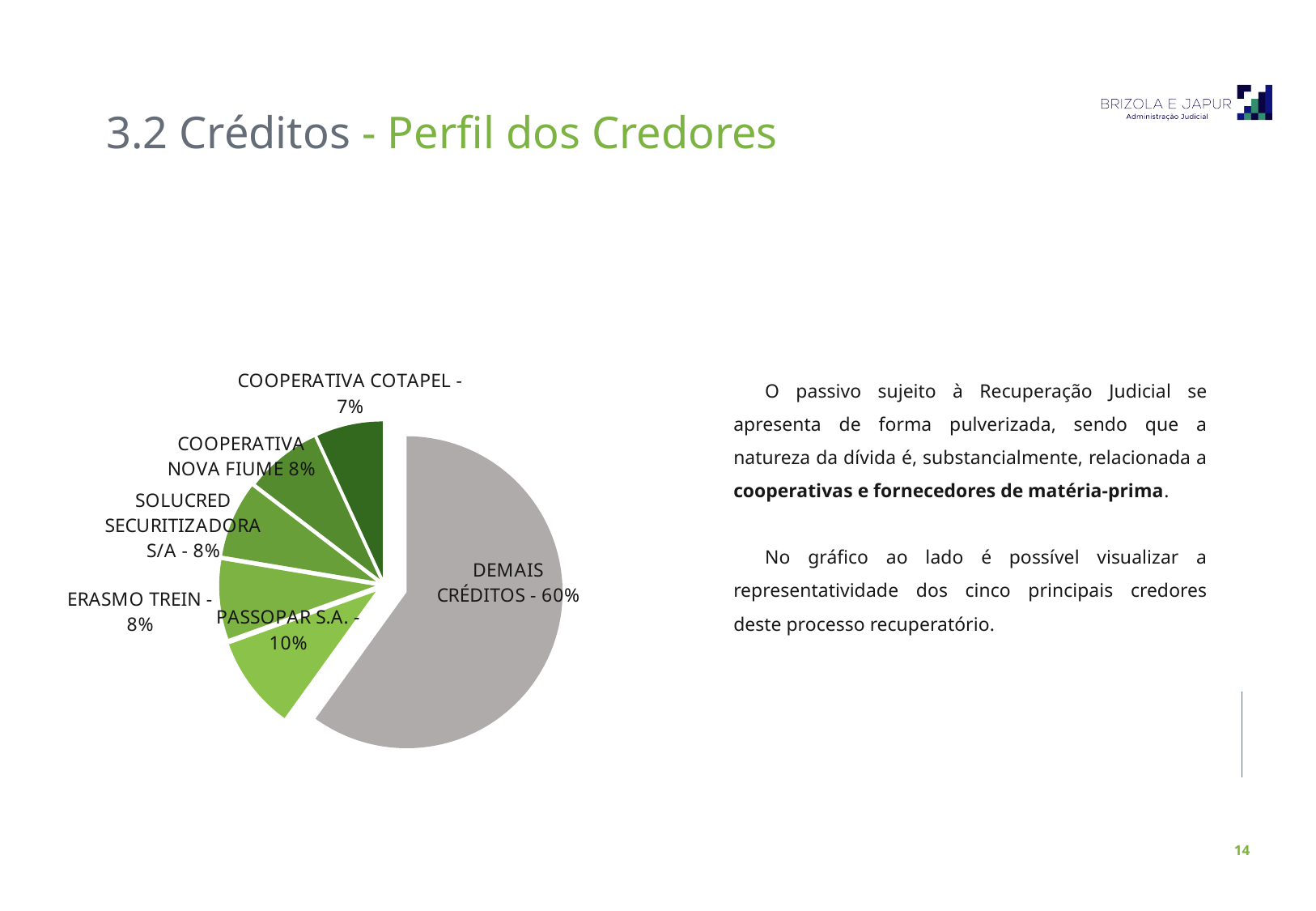
What is the difference between the share of DEMAIS CRÉDITOS and the share of PASSOPAR S.A.? 50% Which slice of the pie chart is the largest? DEMAIS CRÉDITOS What colour is the DEMAIS CRÉDITOS slice? Grey What share of the pie does DEMAIS CRÉDITOS represent? 60% What is the combined share of SOLUCRED SECURITIZADORA S/A and COOPERATIVA NOVA FIUME? 16% What is the value shown for COOPERATIVA COTAPEL? 7% Which is larger, the share of PASSOPAR S.A. or the share of COOPERATIVA COTAPEL? PASSOPAR S.A. What type of chart is shown on the slide? Pie chart Which slice of the pie chart is the smallest? COOPERATIVA COTAPEL How many slices does the pie chart have? 6 What is the value shown for PASSOPAR S.A.? 10% What is the value shown for ERASMO TREIN? 8%